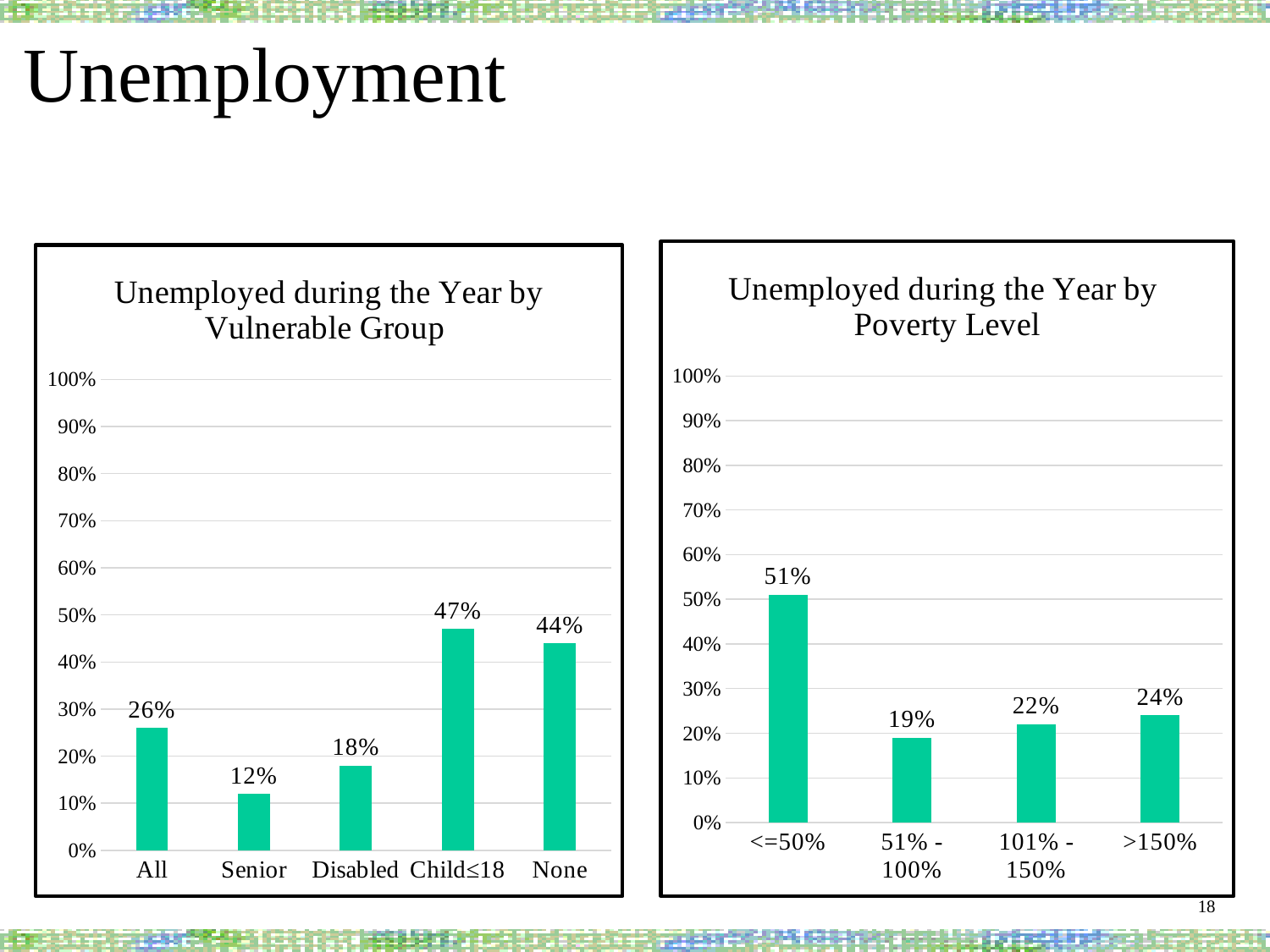
In the 'Unemployed during the Year by Vulnerable Group' chart, what is the value for Senior? 12% In the 'Unemployed during the Year by Vulnerable Group' chart, which category has the highest value? Child≤18 In the 'Unemployed during the Year by Vulnerable Group' chart, what is the difference between the values for Child≤18 and All? 21% In the 'Unemployed during the Year by Vulnerable Group' chart, how many categories are shown? 5 In the 'Unemployed during the Year by Poverty Level' chart, what is the difference between the values for <=50% and >150%? 27% In the 'Unemployed during the Year by Vulnerable Group' chart, what is the value for Disabled? 18% In the 'Unemployed during the Year by Poverty Level' chart, which category has the highest value? <=50% In the 'Unemployed during the Year by Poverty Level' chart, what is the value for the >150% category? 24% In the 'Unemployed during the Year by Vulnerable Group' chart, which category has the lowest value? Senior In the 'Unemployed during the Year by Poverty Level' chart, which is larger, the value for 101% - 150% or the value for 51% - 100%? 101% - 150% In the 'Unemployed during the Year by Poverty Level' chart, what is the value for the 51% - 100% category? 19% What kind of chart is the 'Unemployed during the Year by Poverty Level' chart? Bar chart